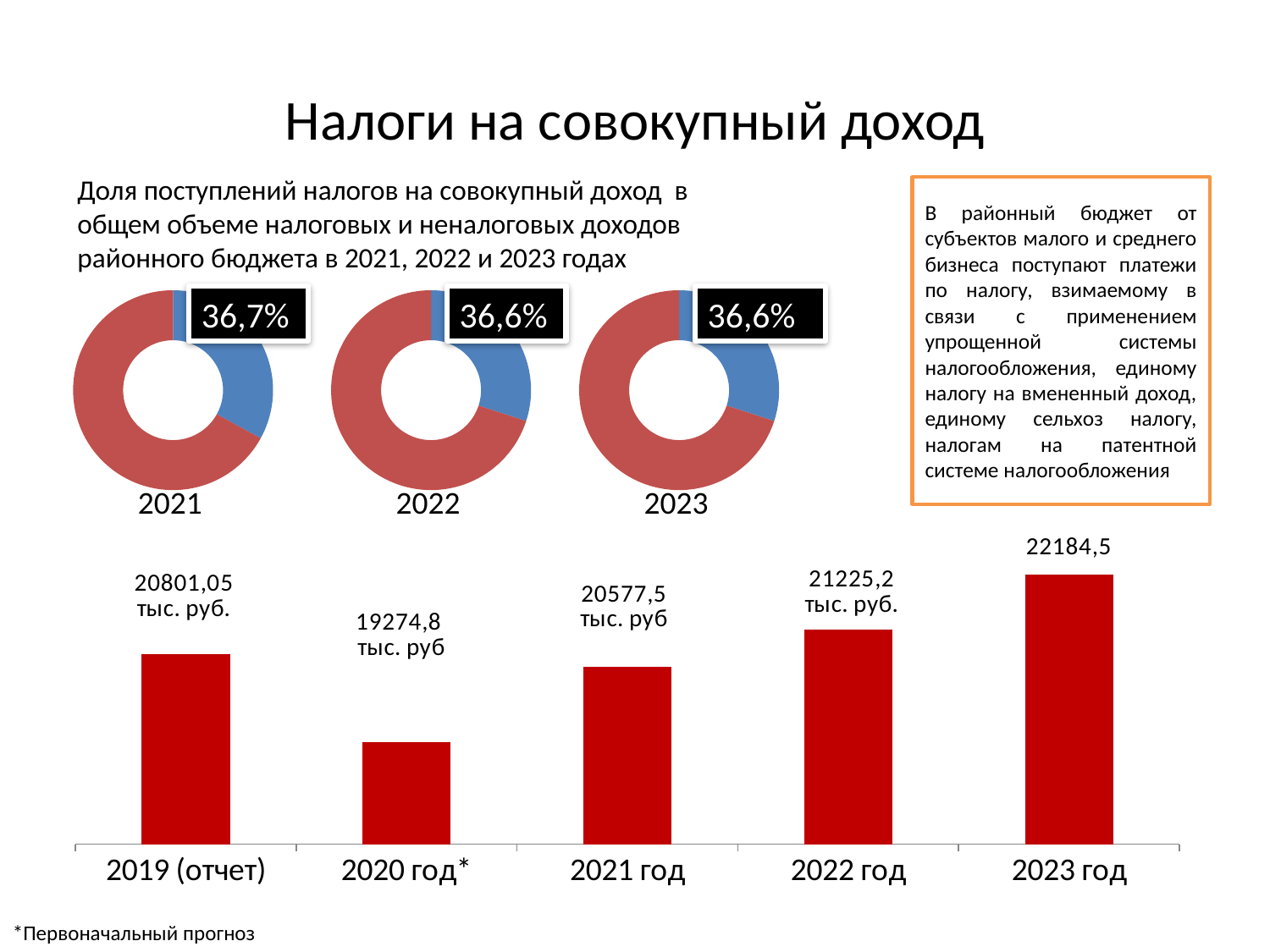
In the bar chart, do the values rise or fall from 2020 год* to 2023 год? rise In the bar chart, which is larger: the value for 2021 год or the value for 2019 (отчет)? 2019 (отчет) What kind of chart is shown at the bottom of the slide? bar chart In the bar chart, what is the value for 2019 (отчет)? 20801,05 тыс. руб. In the bar chart, which year has the lowest value? 2020 год* What percentage is shown on the 2021 donut chart? 36,7% In the bar chart, what is the value for 2023 год? 22184,5 In the bar chart, which year has the highest value? 2023 год In the bar chart, what is the difference between the values for 2023 год and 2022 год? 959,3 In the bar chart, what is the difference between the values for 2019 (отчет) and 2020 год*? 1526,25 In the bar chart, what is the value for 2020 год*? 19274,8 тыс. руб How many bars are in the bar chart at the bottom of the slide? 5